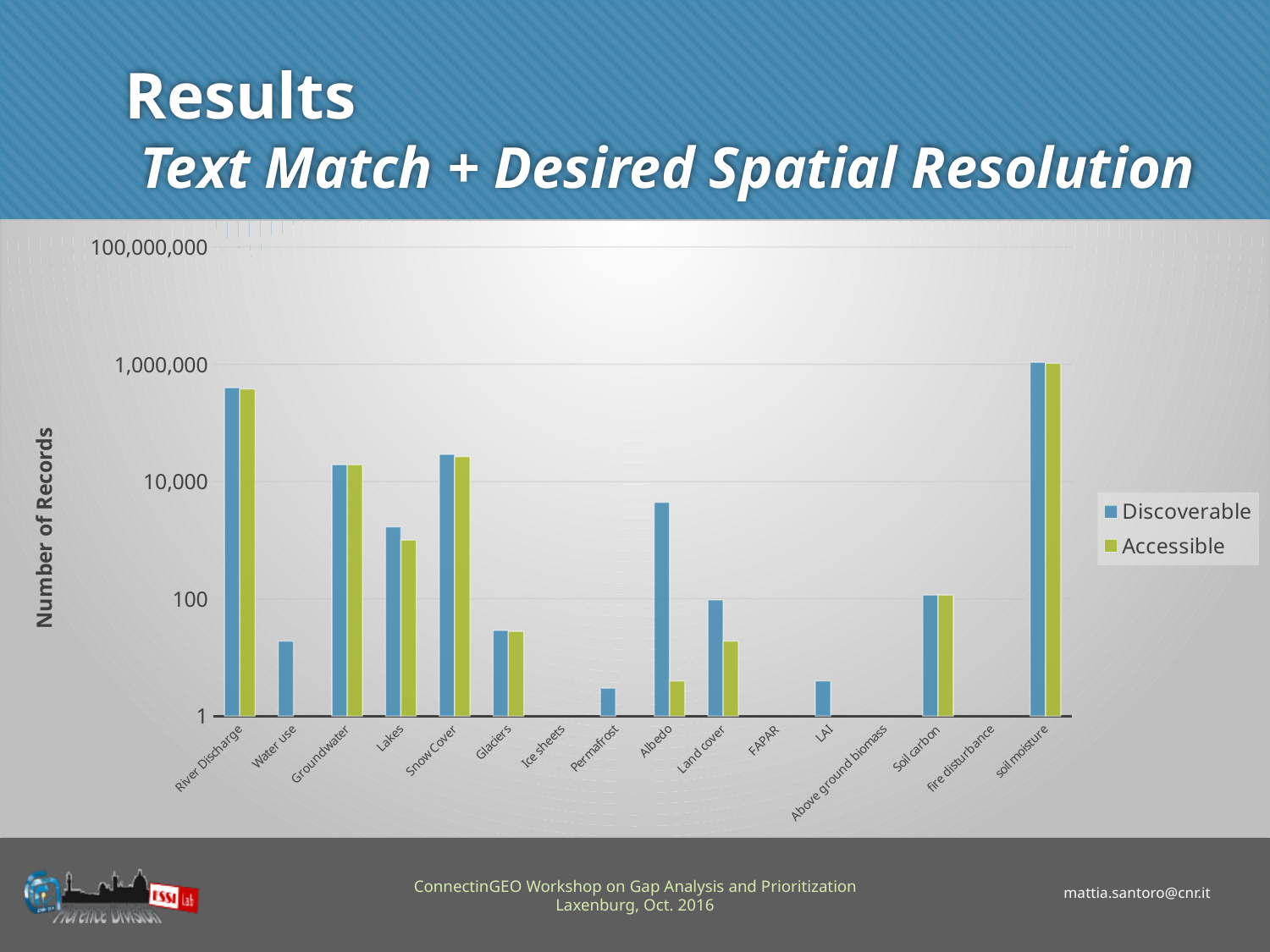
Which category has the highest Accessible value? soil moisture Is the Discoverable value for Albedo greater or less than 10,000? less Is the Discoverable value for Albedo greater or less than 100? greater Which category has the highest Discoverable value? soil moisture How many categories are shown on the x axis? 16 What is the title of the y axis? Number of Records For Albedo, which is larger: the Discoverable value or the Accessible value? Discoverable How many series does the legend list? 2 Is the Discoverable value for Glaciers greater or less than 100? less What kind of chart is shown on the slide? bar chart